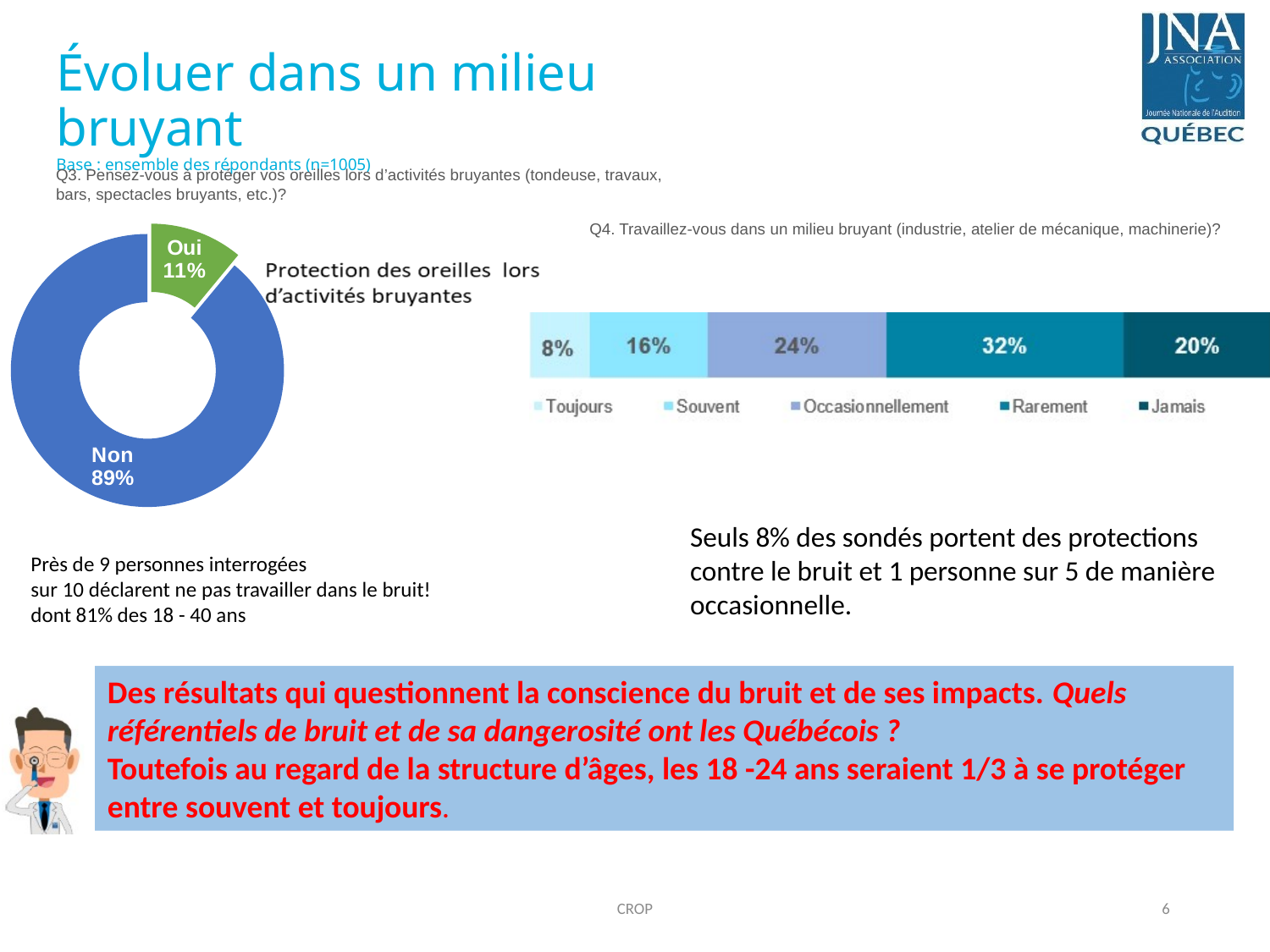
In the stacked bar chart on the right, which category has the lowest value? Toujours In the stacked bar chart on the right, what is the difference in percentage points between "Jamais" and "Souvent"? 4 In the stacked bar chart on the right, which category has the highest value? Rarement In the stacked bar chart on the right, how many categories does the legend list? 5 In the donut chart on the left, what percentage of respondents answered "Oui"? 11% In the donut chart on the left, which category has the larger share, "Oui" or "Non"? Non In the stacked bar chart on the right, what is the value for "Occasionnellement"? 24% In the donut chart on the left, what is the difference in percentage points between "Non" and "Oui"? 78 In the stacked bar chart on the right, what is the value for "Toujours"? 8% In the stacked bar chart on the right, what is the value for "Rarement"? 32% In the donut chart on the left, what percentage of respondents answered "Non"? 89% What kind of chart is the chart on the left of the slide? Donut (pie) chart